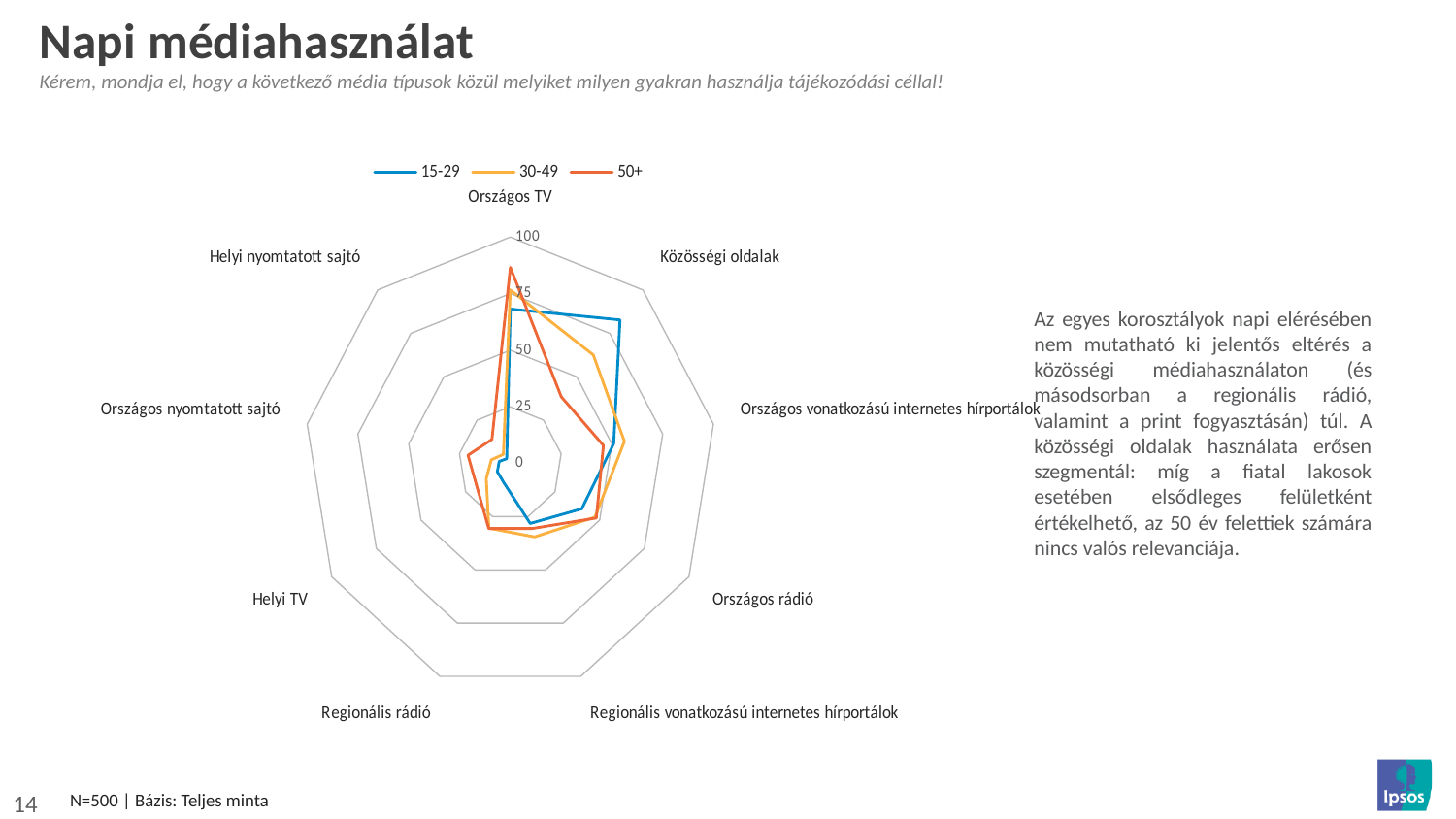
Is the value for Közösségi oldalak in the 15-29 series greater or less than 50? greater For Országos TV, which series has the larger value: 50+ or 15-29? 50+ Is the value for Helyi TV in the 15-29 series greater or less than 50? less For Közösségi oldalak, which series has the larger value: 15-29 or 50+? 15-29 Is the value for Közösségi oldalak in the 50+ series greater or less than 75? less What kind of chart is shown on the slide? Radar chart In the 50+ series, which category has the highest value? Országos TV How many media categories are plotted on the radar chart? 9 How many series does the legend list? 3 Which age groups are listed in the legend? 15-29, 30-49, 50+ What is the title of the slide containing the chart? Napi médiahasználat